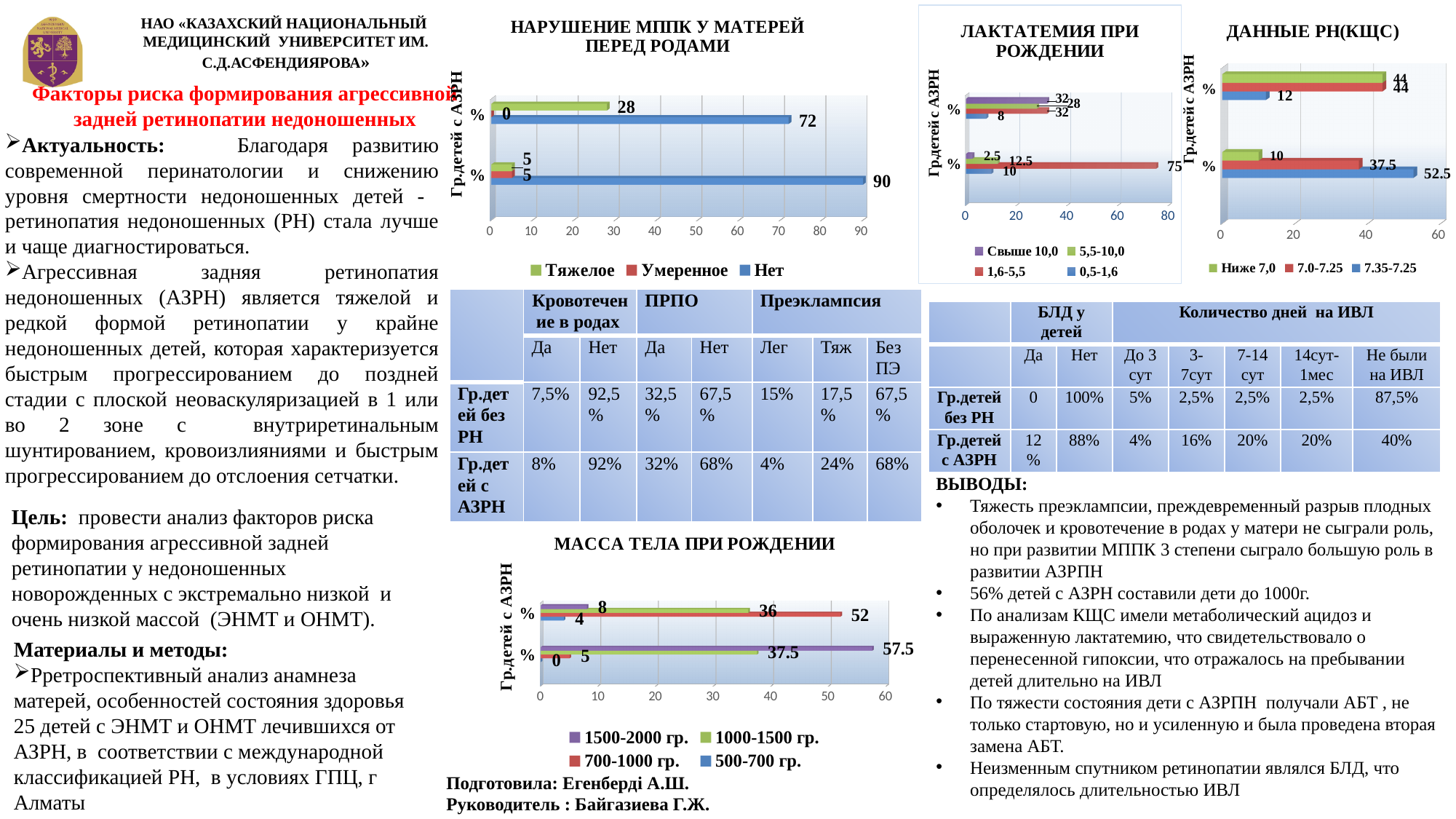
In the chart titled «ЛАКТАТЕМИЯ ПРИ РОЖДЕНИИ», how many series does the legend list? 4 In the chart titled «ДАННЫЕ РН(КЩС)», what is the value of the «7.35-7.25» series in the bottom group of bars? 52.5 In the chart titled «МАССА ТЕЛА ПРИ РОЖДЕНИИ», which series has the highest value in the bottom group of bars? 1500-2000 гр. In the chart titled «МАССА ТЕЛА ПРИ РОЖДЕНИИ», what is the value of the «700-1000 гр.» series in the top group of bars? 52 In the chart titled «НАРУШЕНИЕ МППК У МАТЕРЕЙ ПЕРЕД РОДАМИ», what is the difference between the «Нет» values of the bottom group and the top group? 18 In the chart titled «ЛАКТАТЕМИЯ ПРИ РОЖДЕНИИ», which series has the lowest value in the top group of bars? 0,5-1,6 In the chart titled «НАРУШЕНИЕ МППК У МАТЕРЕЙ ПЕРЕД РОДАМИ», what is the value of the «Тяжелое» series in the top group of bars? 28 In the chart titled «НАРУШЕНИЕ МППК У МАТЕРЕЙ ПЕРЕД РОДАМИ», what is the value of the «Нет» series in the bottom group of bars? 90 What type of chart is «МАССА ТЕЛА ПРИ РОЖДЕНИИ»? Bar chart In the chart titled «ЛАКТАТЕМИЯ ПРИ РОЖДЕНИИ», what is the value of the «1,6-5,5» series in the bottom group of bars? 75 In the chart titled «НАРУШЕНИЕ МППК У МАТЕРЕЙ ПЕРЕД РОДАМИ», how many series does the legend list? 3 In the chart titled «ДАННЫЕ РН(КЩС)», which series has the lowest value in the top group of bars? 7.35-7.25